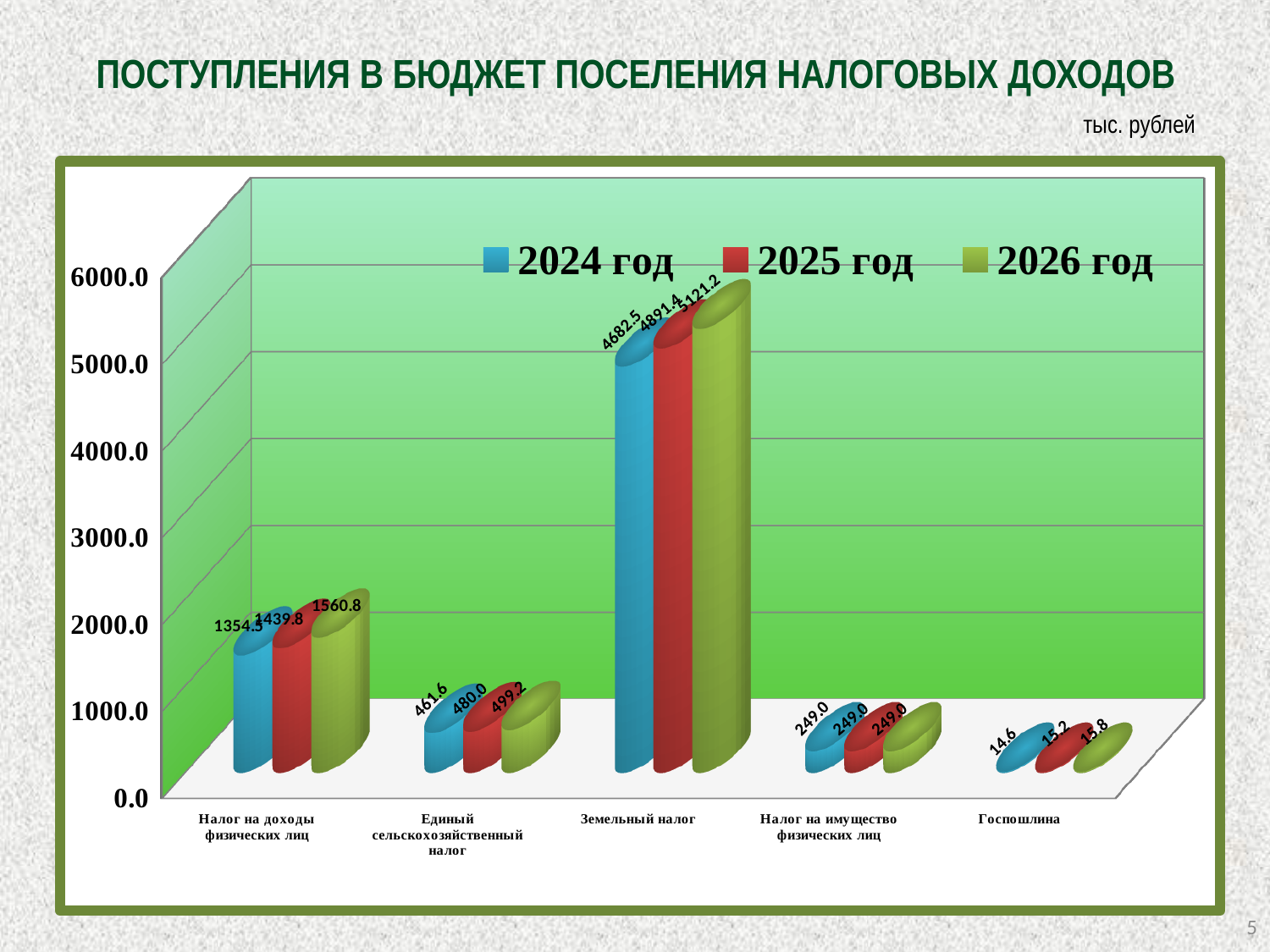
What is the value for Налог на имущество физических лиц in 2026 год? 249.0 Is the value for Земельный налог in 2024 год greater or less than 4000.0? greater How many categories are shown on the x axis? 5 How many series does the legend list? 3 What is the value for Земельный налог in 2026 год? 5121.2 What is the value for Единый сельскохозяйственный налог in 2025 год? 480.0 What is the value for Госпошлина in 2024 год? 14.6 Which is larger in 2026 год: Налог на доходы физических лиц or Единый сельскохозяйственный налог? Налог на доходы физических лиц What is the difference between the 2026 год and 2024 год values for Единый сельскохозяйственный налог? 37.6 What is the difference between the 2026 год and 2025 год values for Земельный налог? 229.8 Which category has the lowest value in 2026 год? Госпошлина Which category has the highest value in 2025 год? Земельный налог